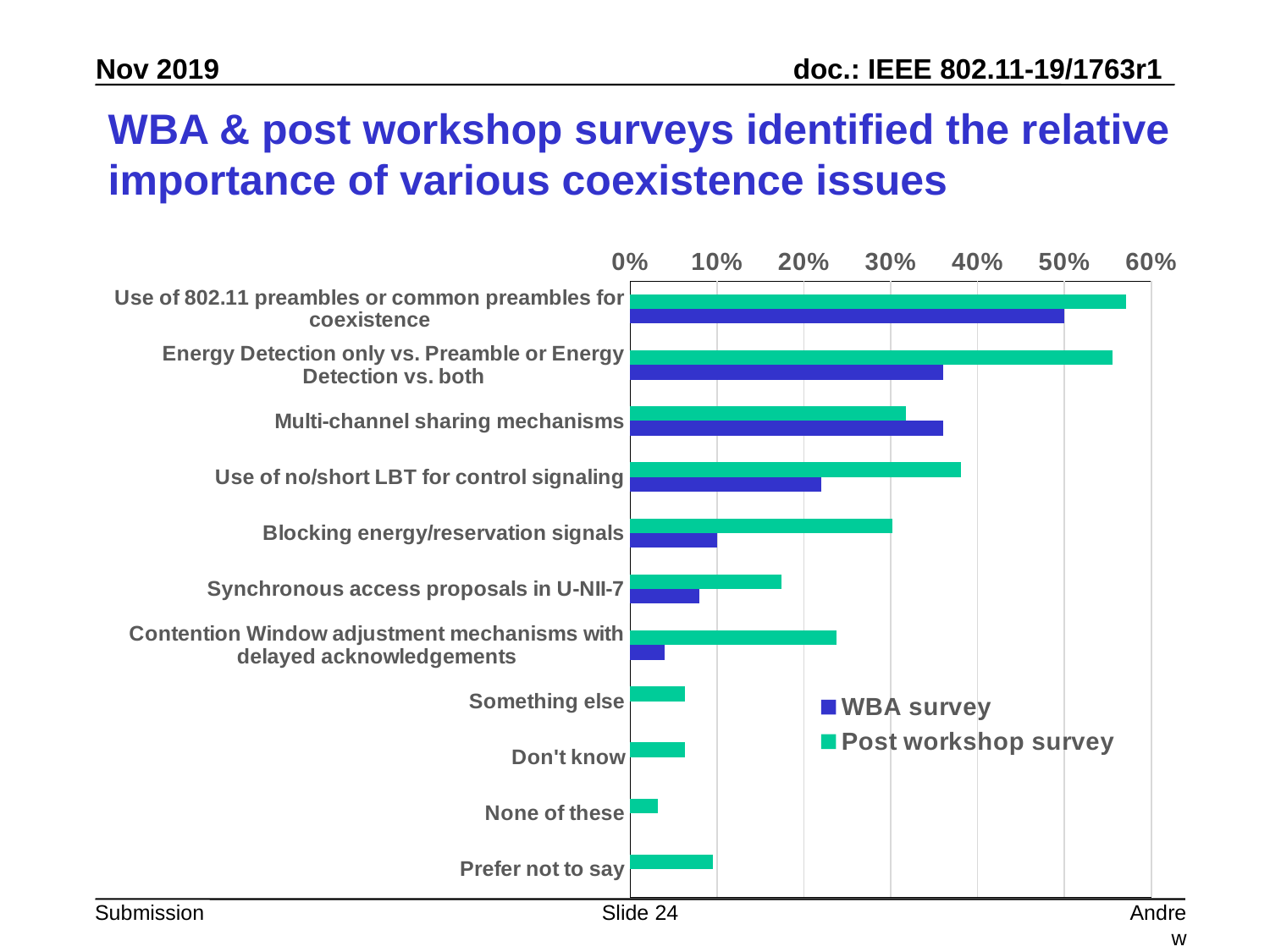
Which category has the lowest value for the Post workshop survey series? None of these How many categories are plotted on the chart? 11 For 'Multi-channel sharing mechanisms', which series has the larger value, WBA survey or Post workshop survey? WBA survey Which colour represents the Post workshop survey series in the legend? green What kind of chart is shown on the slide? bar chart Is the Post workshop survey value for 'Synchronous access proposals in U-NII-7' greater or less than 20%? less Which category has the highest value for the WBA survey series? Use of 802.11 preambles or common preambles for coexistence Is the WBA survey value for 'Energy Detection only vs. Preamble or Energy Detection vs. both' greater or less than 30%? greater For 'Blocking energy/reservation signals', which series has the larger value, WBA survey or Post workshop survey? Post workshop survey Is the Post workshop survey value for 'Use of 802.11 preambles or common preambles for coexistence' greater or less than 50%? greater How many series does the legend list? 2